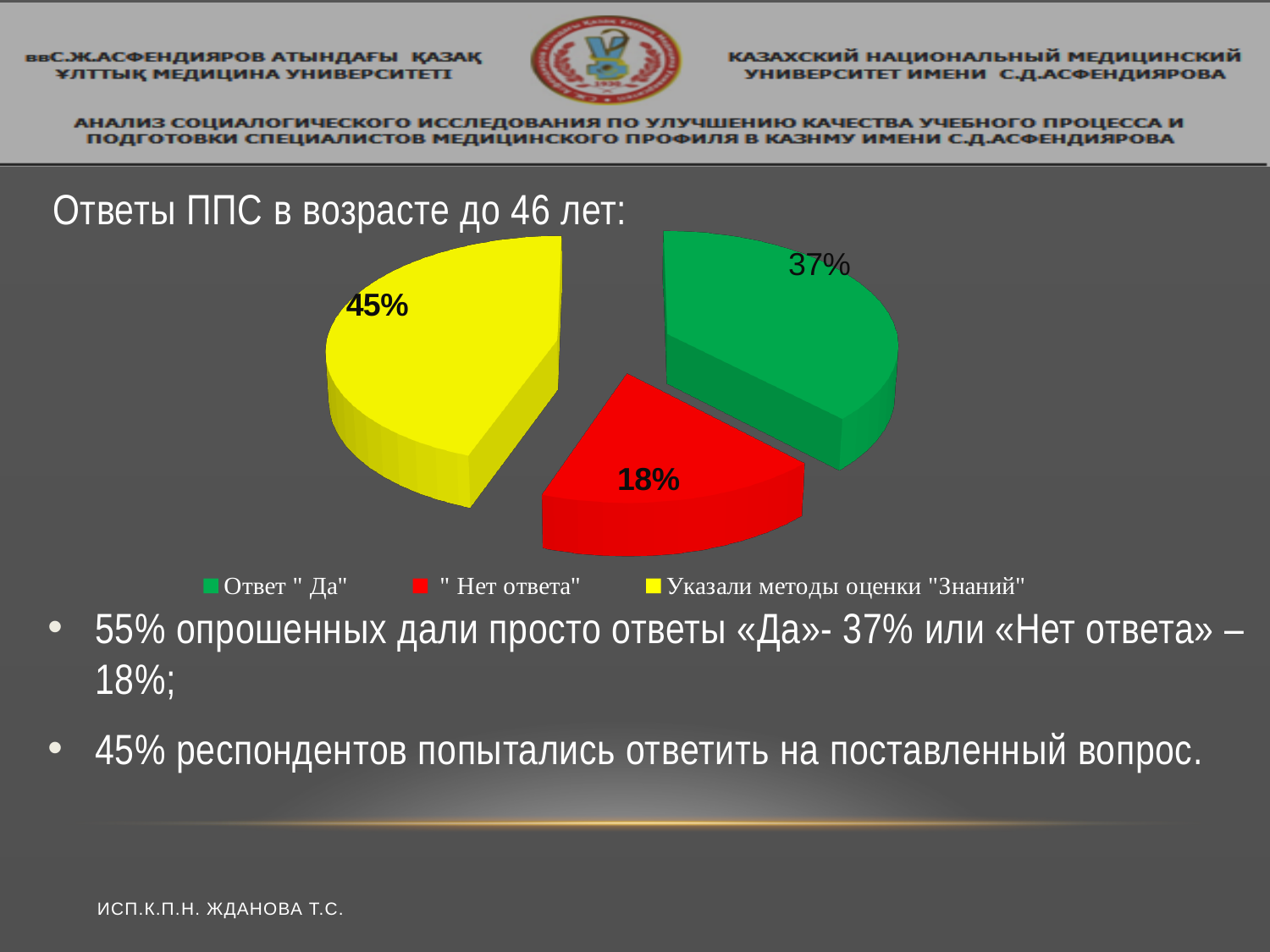
What share of the pie is labelled "Нет ответа"? 18% How many slices does the pie chart have? 3 What share of the pie is labelled Указали методы оценки "Знаний"? 45% What kind of chart is shown on the slide? pie chart What is the difference in percentage points between the Ответ "Да" slice and the "Нет ответа" slice? 19 What colour is the slice for "Нет ответа"? red Which category has the largest slice of the pie? Указали методы оценки "Знаний" Which category has the smallest slice of the pie? "Нет ответа" What colour is the slice for Ответ "Да"? green Which is larger: the Ответ "Да" slice or the Указали методы оценки "Знаний" slice? Указали методы оценки "Знаний" What share of the pie is labelled Ответ "Да"? 37% How many entries does the legend list? 3